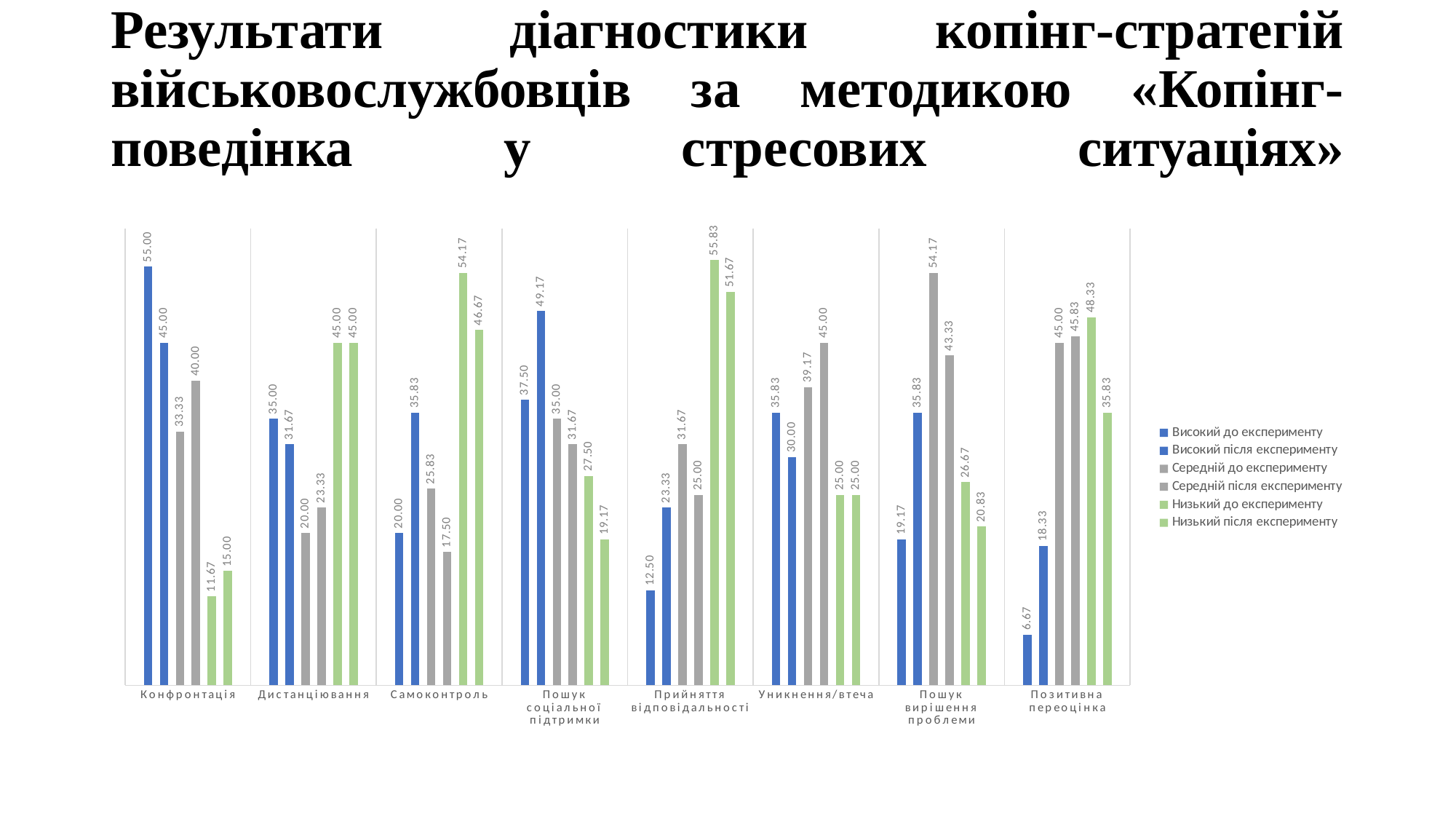
In the "Самоконтроль" category, which is larger: "Низький до експерименту" or "Низький після експерименту"? Низький до експерименту How many categories are shown on the x axis? 8 What is the difference between "Високий до експерименту" and "Високий після експерименту" in the "Конфронтація" category? 10.00 What is the value for "Високий до експерименту" in the "Конфронтація" category? 55.00 How many series does the legend list? 6 What is the value for "Середній після експерименту" in the "Уникнення/втеча" category? 45.00 What colour are the bars for the "Низький" series in the chart? green Which category has the highest value for "Середній до експерименту"? Пошук вирішення проблеми Which category has the lowest value for "Високий до експерименту"? Позитивна переоцінка What type of chart is shown on the slide? bar chart What is the value for "Низький до експерименту" in the "Прийняття відповідальності" category? 55.83 What is the value for "Високий до експерименту" in the "Позитивна переоцінка" category? 6.67